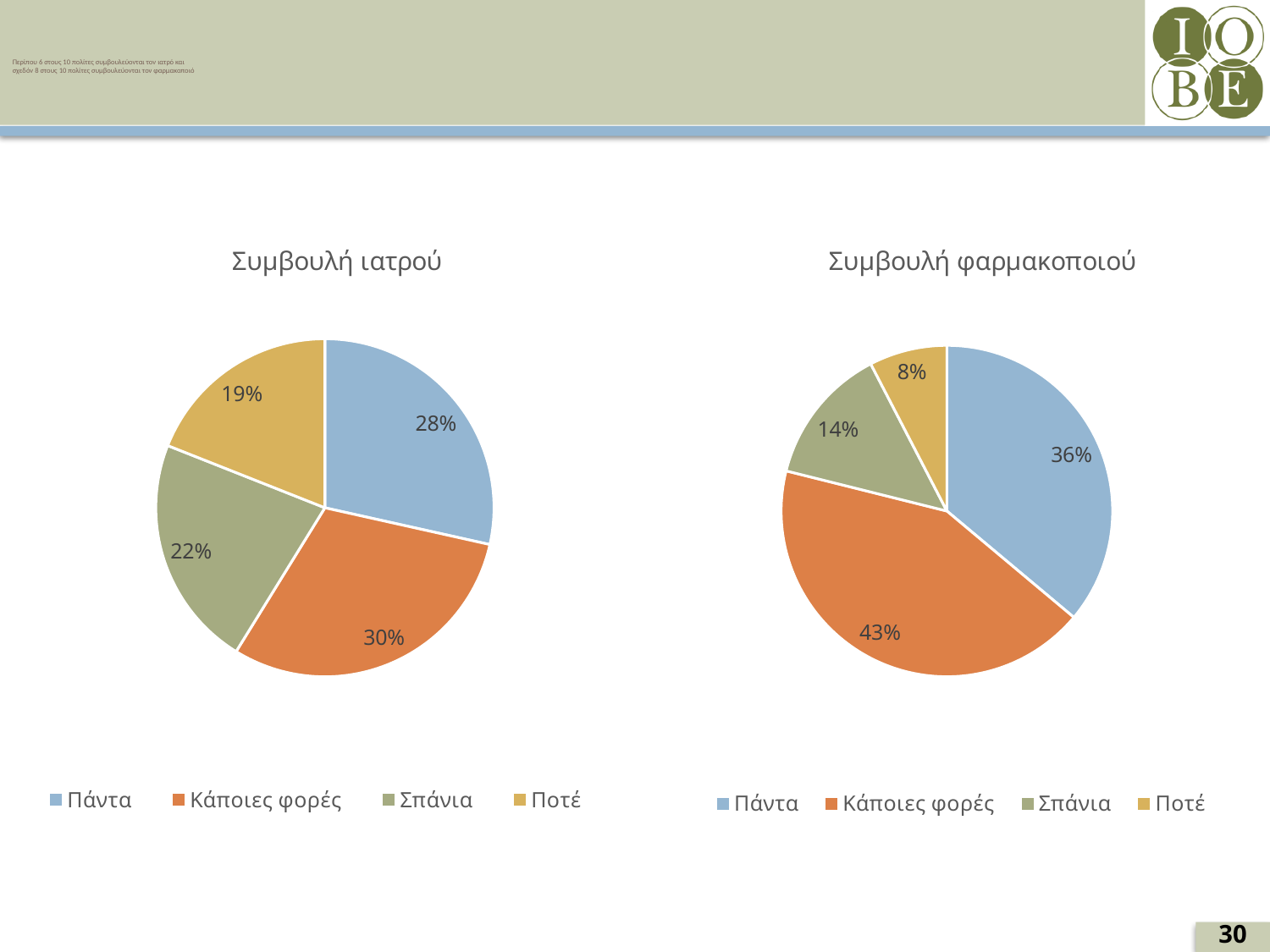
What type of chart is "Συμβουλή ιατρού"? Pie chart In the "Συμβουλή ιατρού" chart, what share is labelled for Πάντα? 28% In the "Συμβουλή ιατρού" chart, which is larger: the Σπάνια slice or the Ποτέ slice? Σπάνια In the "Συμβουλή φαρμακοποιού" chart, what is the difference between the Κάποιες φορές and Πάντα shares? 7% In the "Συμβουλή ιατρού" chart, what share is labelled for Ποτέ? 19% In the "Συμβουλή φαρμακοποιού" chart, what share is labelled for Σπάνια? 14% In the "Συμβουλή φαρμακοποιού" chart, what colour is the Πάντα slice? Blue In the "Συμβουλή φαρμακοποιού" chart, which category has the smallest slice? Ποτέ In the "Συμβουλή ιατρού" chart, which category has the smallest slice? Ποτέ How many slices does the "Συμβουλή φαρμακοποιού" chart have? 4 In the "Συμβουλή ιατρού" chart, which category has the largest slice? Κάποιες φορές In the "Συμβουλή φαρμακοποιού" chart, what share is labelled for Κάποιες φορές? 43%